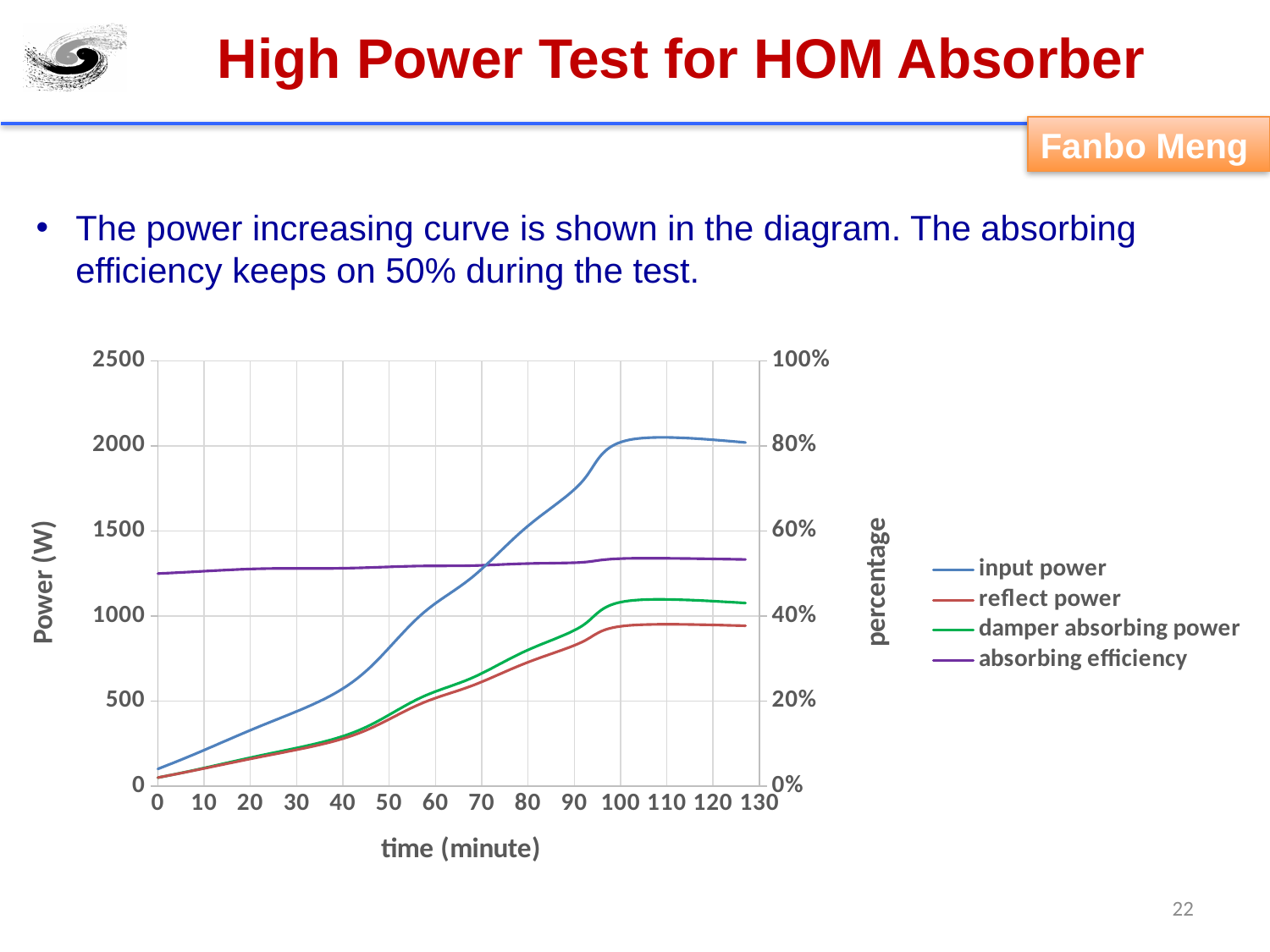
Which series are listed in the chart legend? input power, reflect power, damper absorbing power, absorbing efficiency Does the input power rise or fall between 0 and 100 minutes? rise How many series does the chart legend list? 4 What kind of chart is shown on the slide? line chart Is the reflect power at 130 minutes greater or less than 1000 W? less Which series reaches the highest value on the Power (W) axis? input power What is the title of the horizontal axis of the chart? time (minute) At 110 minutes, which is larger: damper absorbing power or reflect power? damper absorbing power Among the three power series, which is lowest at 130 minutes? reflect power Is the absorbing efficiency at 60 minutes greater or less than 40%? greater Is the input power at 90 minutes greater or less than 1500 W? greater